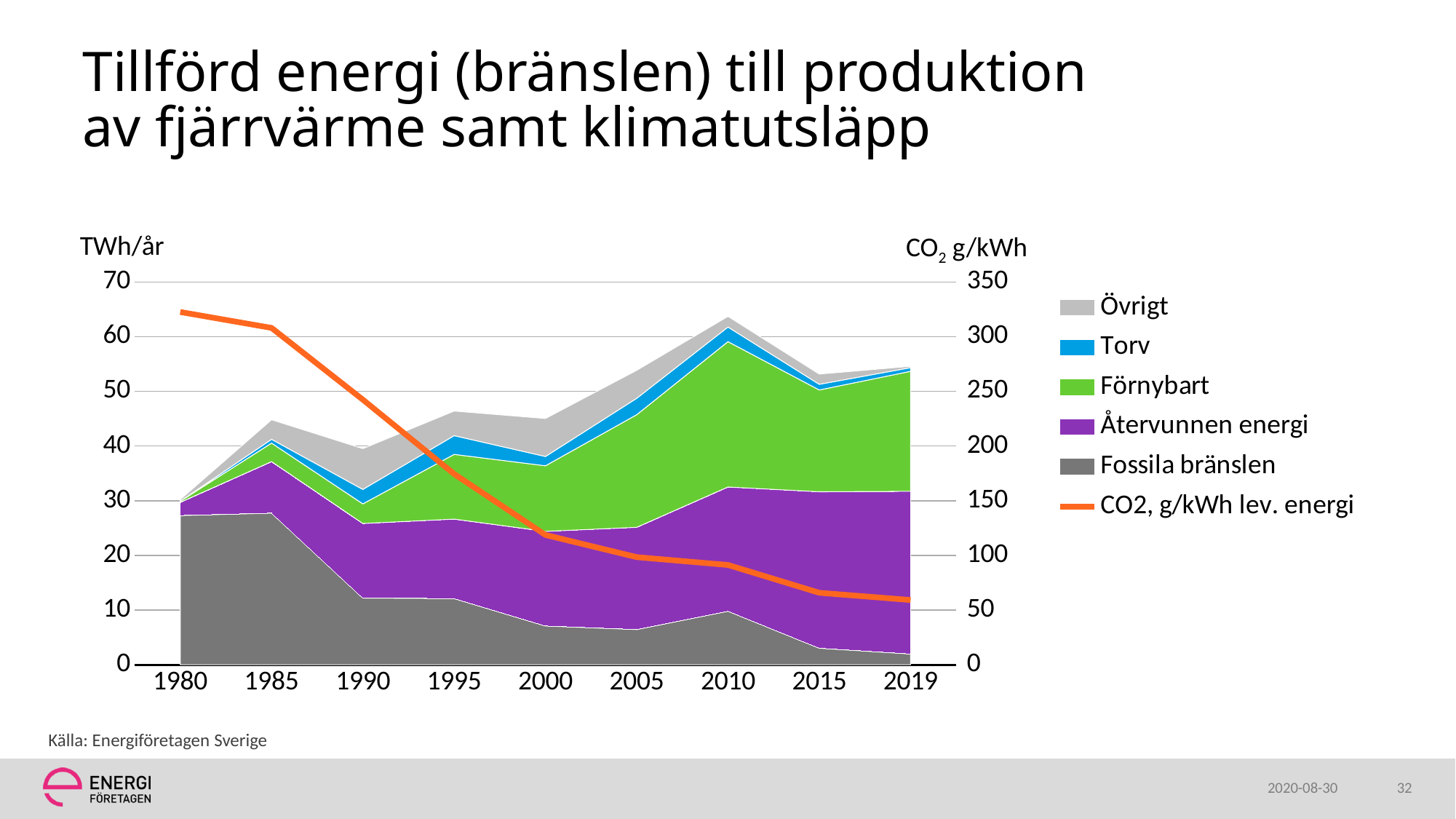
Does the CO2, g/kWh lev. energi line rise or fall from 1980 to 2019? Fall In which year is the CO2, g/kWh lev. energi line at its highest? 1980 Is the Fossila bränslen value for 2019 greater or less than 10 TWh/år? less Which year has the larger CO2, g/kWh lev. energi value, 1980 or 2019? 1980 What kind of chart is shown on the slide? A stacked area chart with a line Is the CO2, g/kWh lev. energi value for 1980 greater or less than 300? greater Is the Fossila bränslen value for 1980 greater or less than 20 TWh/år? greater In which year is the total stacked energy supply (top of the stacked areas) highest? 2010 How many series does the legend list? 6 What unit is shown on the left vertical axis? TWh/år How many years are shown along the x axis? 9